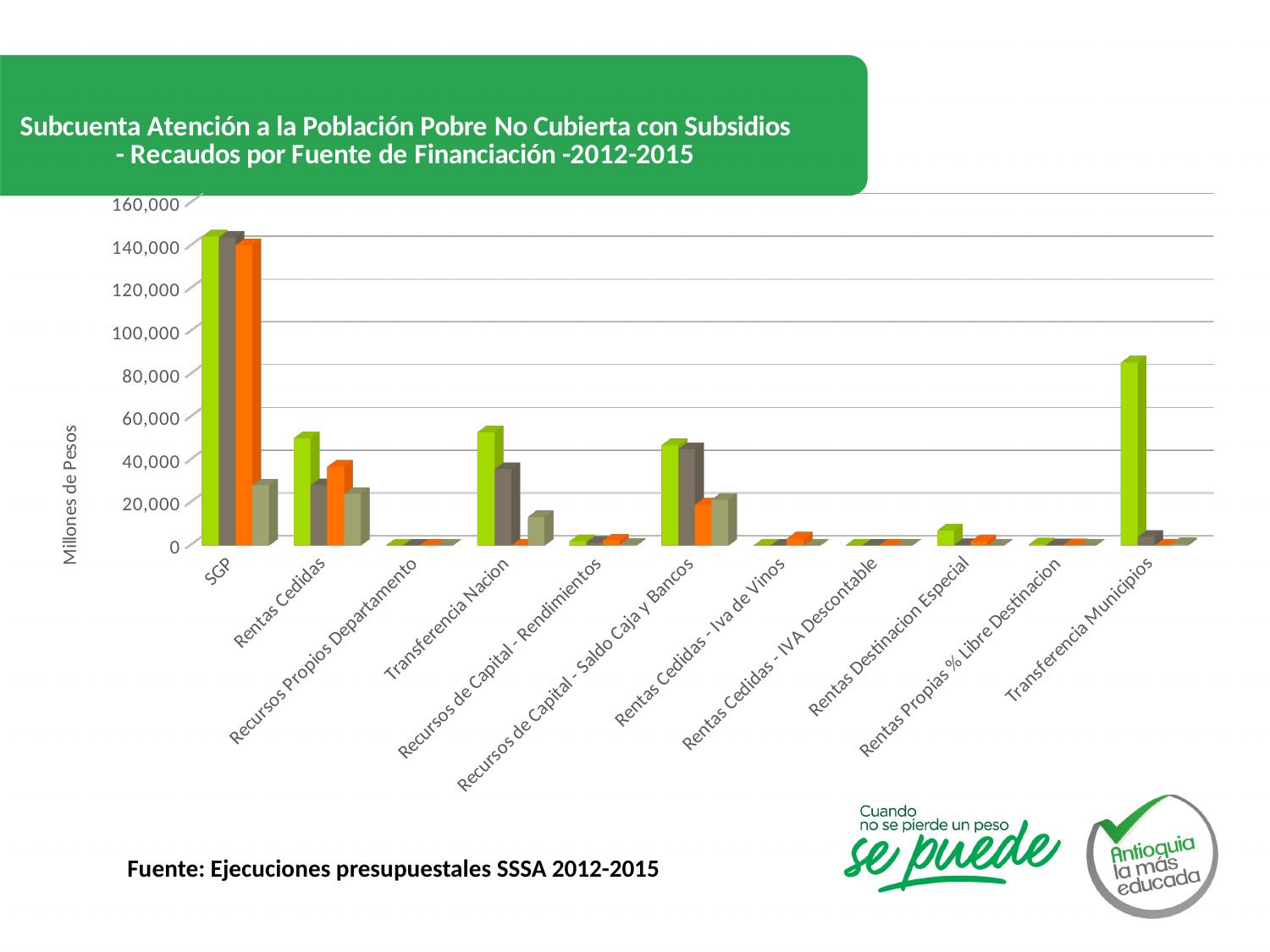
Is the value of the green bar for Transferencia Nacion greater or less than 40,000? greater What kind of chart is shown on the slide? Bar chart What is the title of the chart on the slide? Subcuenta Atención a la Población Pobre No Cubierta con Subsidios - Recaudos por Fuente de Financiación -2012-2015 Which is larger: the green bar for SGP or the green bar for Transferencia Municipios? SGP Which is larger: the green bar for Transferencia Municipios or the green bar for Rentas Cedidas? Transferencia Municipios What is the label on the vertical axis of the chart? Millones de Pesos Which category has the tallest bar in the chart? SGP Is the value of the green bar for SGP greater or less than 120,000? greater Is the value of the green bar for Transferencia Municipios greater or less than 60,000? greater How many categories are shown along the x axis of the chart? 11